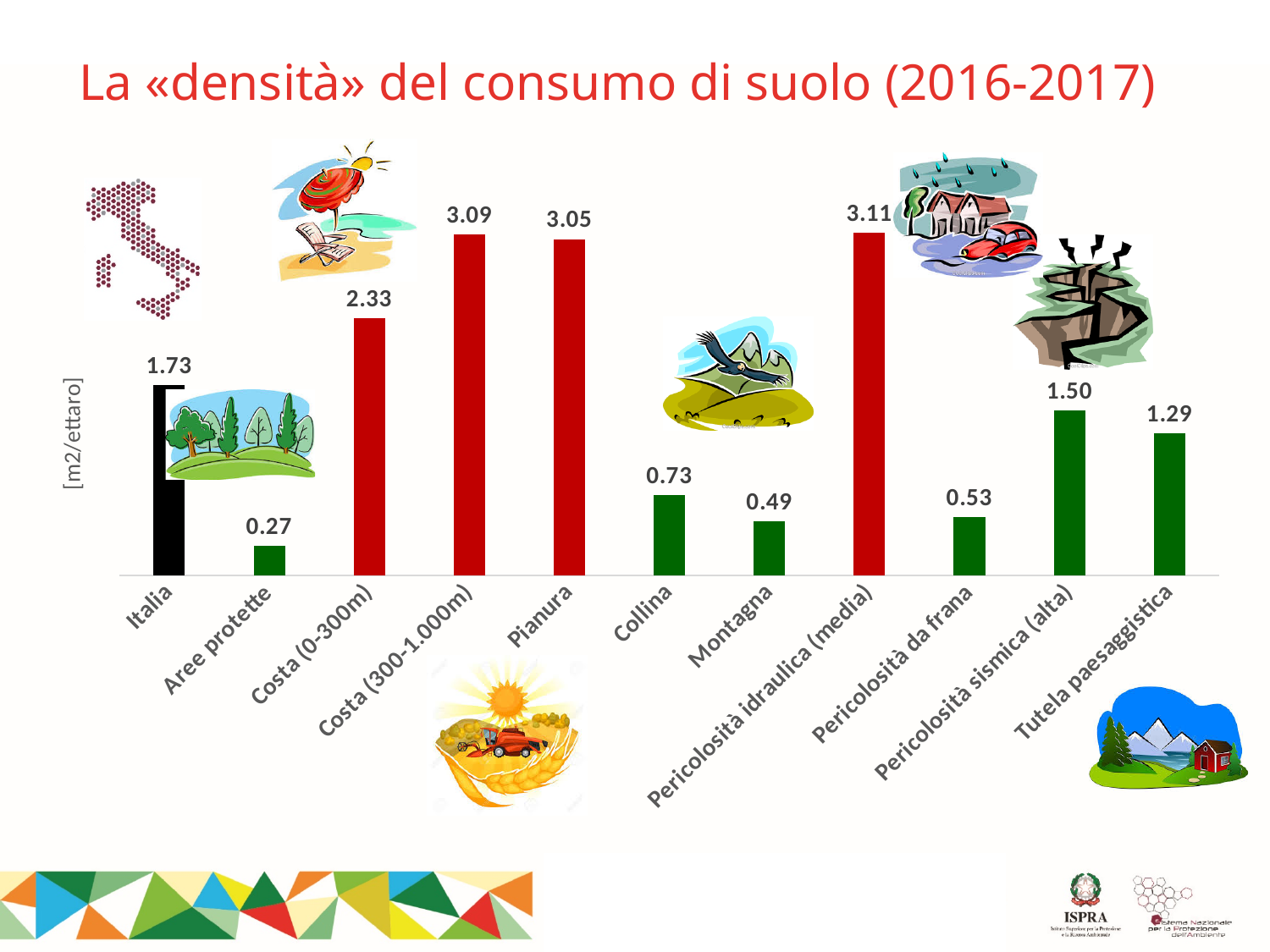
Which category has the lowest value? Aree protette What unit is shown on the vertical axis label? [m2/ettaro] What is the difference between the values for Costa (300-1.000m) and Costa (0-300m)? 0.76 What is the value for Tutela paesaggistica? 1.29 What is the value for Italia? 1.73 How many categories are shown on the x axis? 11 What kind of chart is shown on the slide? Bar chart What is the value for Pericolosità idraulica (media)? 3.11 What is the value for Aree protette? 0.27 What is the difference between the values for Italia and Aree protette? 1.46 Which is larger, the value for Collina or the value for Montagna? Collina Which category has the highest value? Pericolosità idraulica (media)